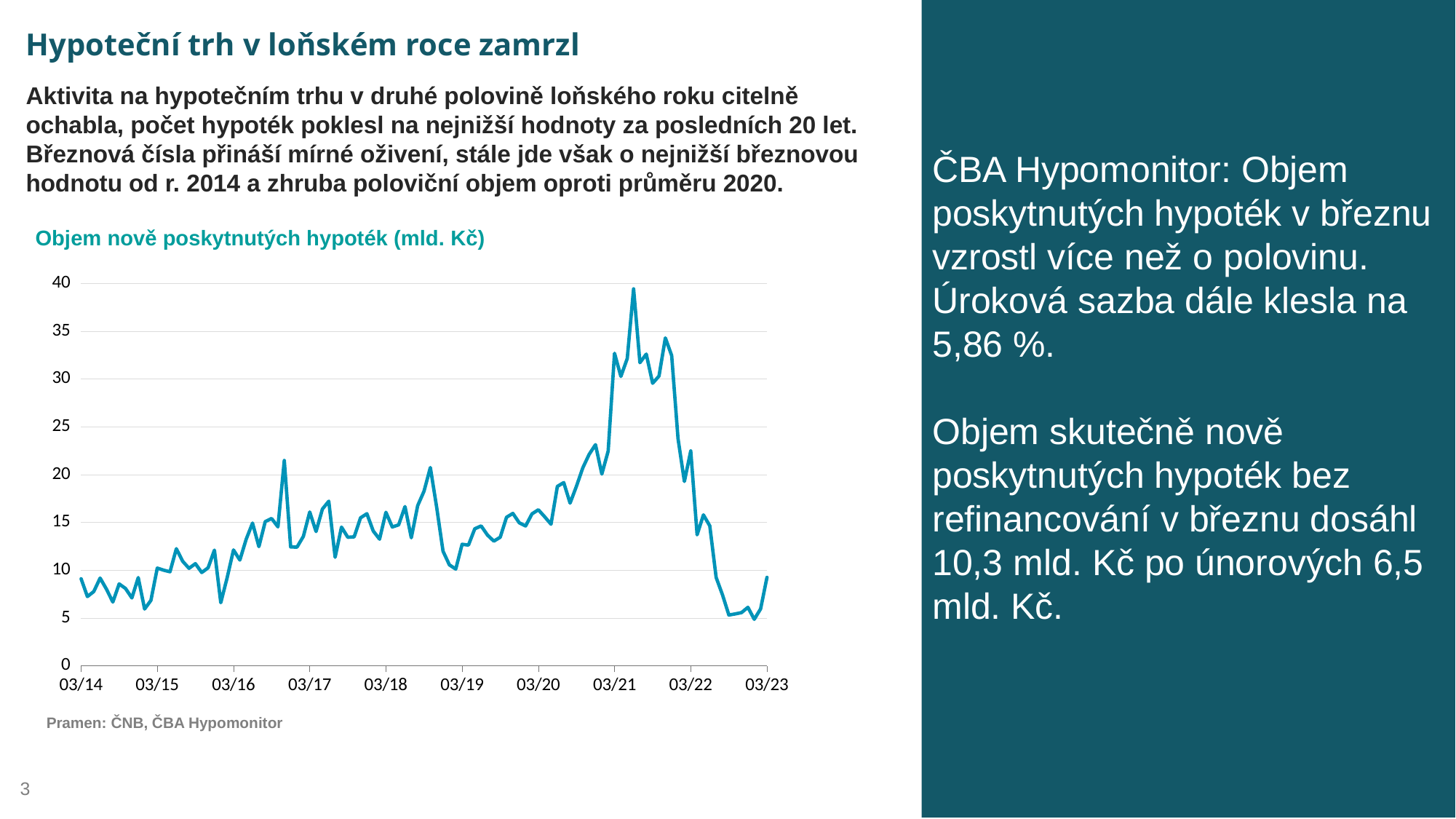
Does the line rise or fall between 03/20 and 03/21? rise Is the value at 03/14 greater or less than 10? less What kind of chart is shown on the slide? line chart What is the title of the chart? Objem nově poskytnutých hypoték (mld. Kč) Does the line rise or fall between 03/22 and 03/23? fall How many labelled tick marks are there on the x axis of the chart? 10 Is the value at 03/19 greater or less than 15? less Is the highest point of the line greater or less than 35? greater What source is cited below the chart? ČNB, ČBA Hypomonitor